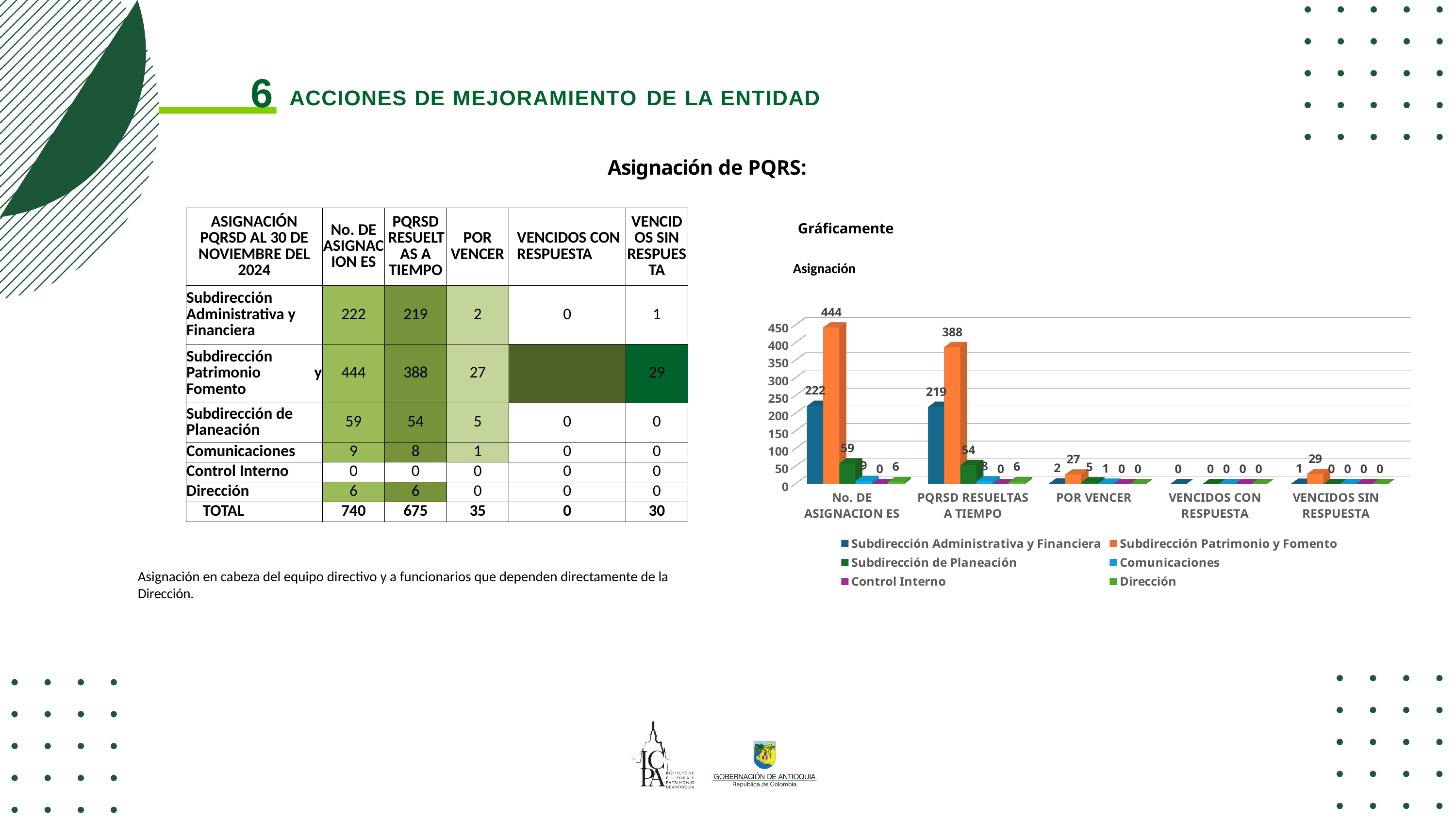
How many series does the chart legend list? 6 What is the value for Subdirección Patrimonio y Fomento in the POR VENCER category? 27 What is the value for Subdirección Administrativa y Financiera in the PQRSD RESUELTAS A TIEMPO category? 219 What is the title of the chart? Asignación How many categories are shown on the x axis of the chart? 5 Is the value for Subdirección Patrimonio y Fomento in PQRSD RESUELTAS A TIEMPO greater or less than 350? greater What is the difference between the Subdirección Patrimonio y Fomento values for No. DE ASIGNACIONES and PQRSD RESUELTAS A TIEMPO? 56 What is the value for Subdirección Patrimonio y Fomento in the No. DE ASIGNACIONES category? 444 Which series has the highest value in the No. DE ASIGNACIONES category? Subdirección Patrimonio y Fomento What is the value for Subdirección Patrimonio y Fomento in the VENCIDOS SIN RESPUESTA category? 29 What type of chart is shown on the slide? bar chart Which is larger in the PQRSD RESUELTAS A TIEMPO category: Subdirección Administrativa y Financiera or Subdirección de Planeación? Subdirección Administrativa y Financiera